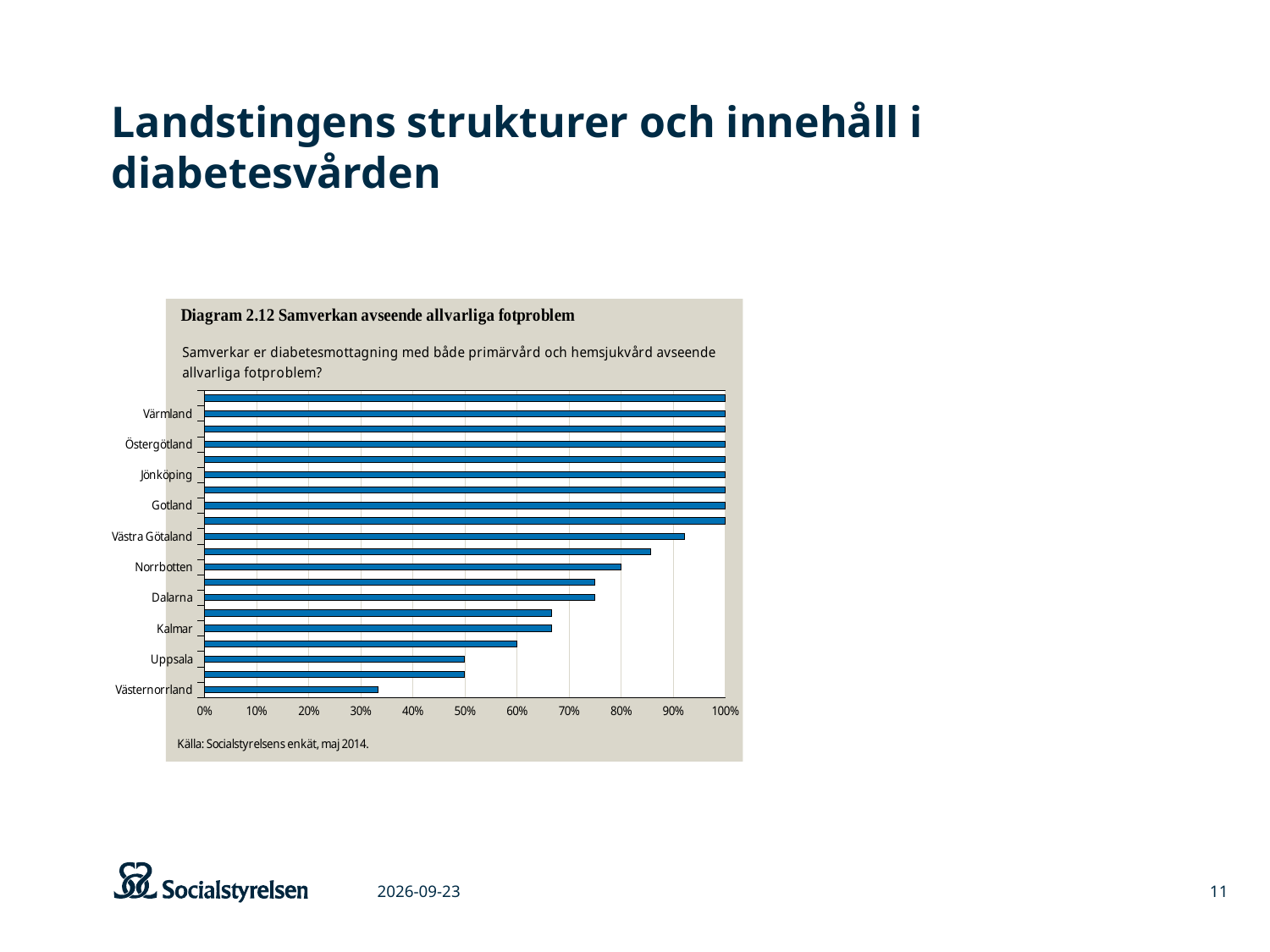
What is the value for Gotland? 100% What is the value for Uppsala? 50% Which is larger, the value for Norrbotten or the value for Uppsala? Norrbotten What is the difference between the values for Norrbotten and Uppsala? 30 percentage points What kind of chart is shown on the slide? Bar chart What is the title of the diagram on the slide? Diagram 2.12 Samverkan avseende allvarliga fotproblem According to the note below the chart, what is the source of the data? Socialstyrelsens enkät, maj 2014 Which labelled region has the lowest value? Västernorrland Is the value for Dalarna greater or less than 70%? greater What is the value for Värmland? 100% Is the value for Västernorrland greater or less than 40%? less What is the value for Norrbotten? 80%